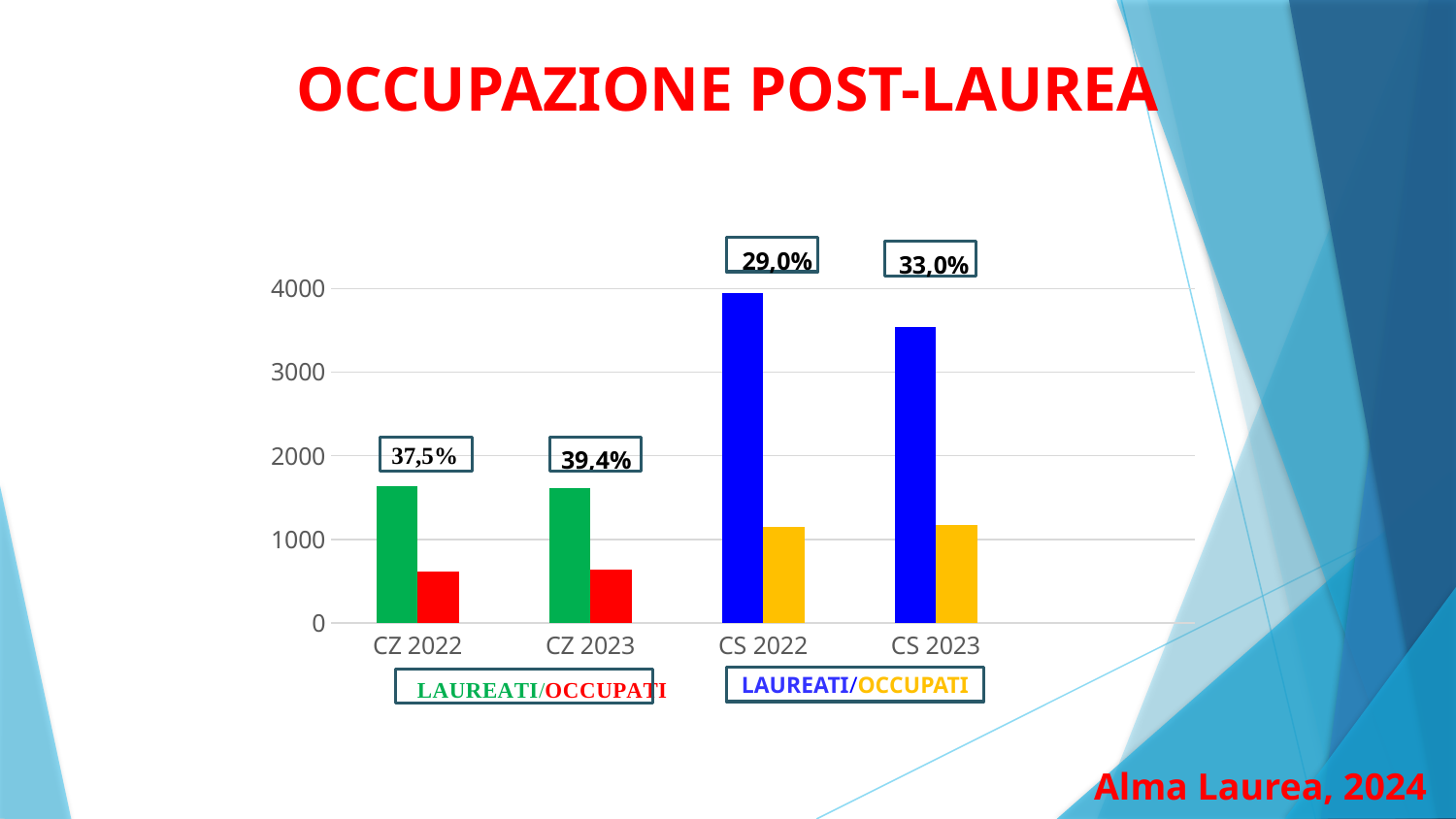
What percentage label is shown above the CZ 2022 bars? 37,5% What percentage label is shown above the CS 2023 bars? 33,0% Which is larger, the LAUREATI bar for CS 2022 or the LAUREATI bar for CS 2023? CS 2022 Is the LAUREATI value for CZ 2022 greater or less than 2000? less What is the title of the chart on the slide? OCCUPAZIONE POST-LAUREA Is the LAUREATI value for CS 2023 greater or less than 3000? greater Is the OCCUPATI value for CZ 2022 greater or less than 1000? less What percentage label is shown above the CS 2022 bars? 29,0% What kind of chart is shown on the slide? bar chart What percentage label is shown above the CZ 2023 bars? 39,4% How many categories are shown on the x axis of the chart? 4 Which category has the tallest LAUREATI bar? CS 2022